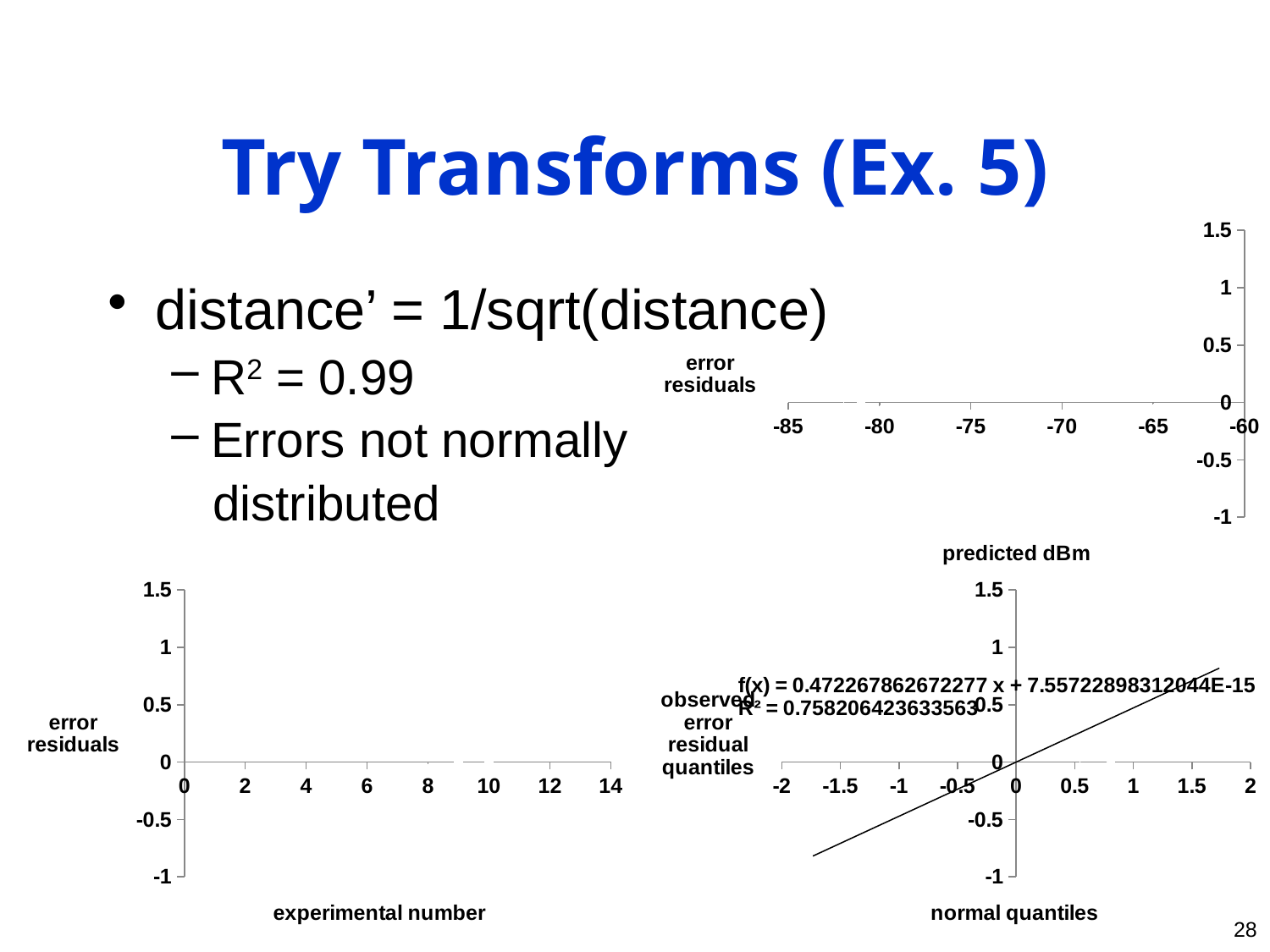
On the top-right chart, what is the lowest value labelled on the x axis? -85 On the bottom-right chart, what is the R² value printed next to the trendline? 0.758206423633563 On the bottom-right chart, does the trendline rise or fall as the normal quantiles increase from left to right? rise On the bottom-right chart, what is the intercept term in the printed trendline equation f(x)? 7.55722898312044E-15 What is the x-axis title of the top-right chart? predicted dBm What kind of chart is the bottom-right chart with the trendline? scatter chart How many charts are shown on the slide? 3 What is the x-axis title of the bottom-left chart? experimental number On the bottom-left chart, what is the highest value labelled on the x axis? 14 On the bottom-right chart, what is the slope coefficient in the printed trendline equation f(x)? 0.472267862672277